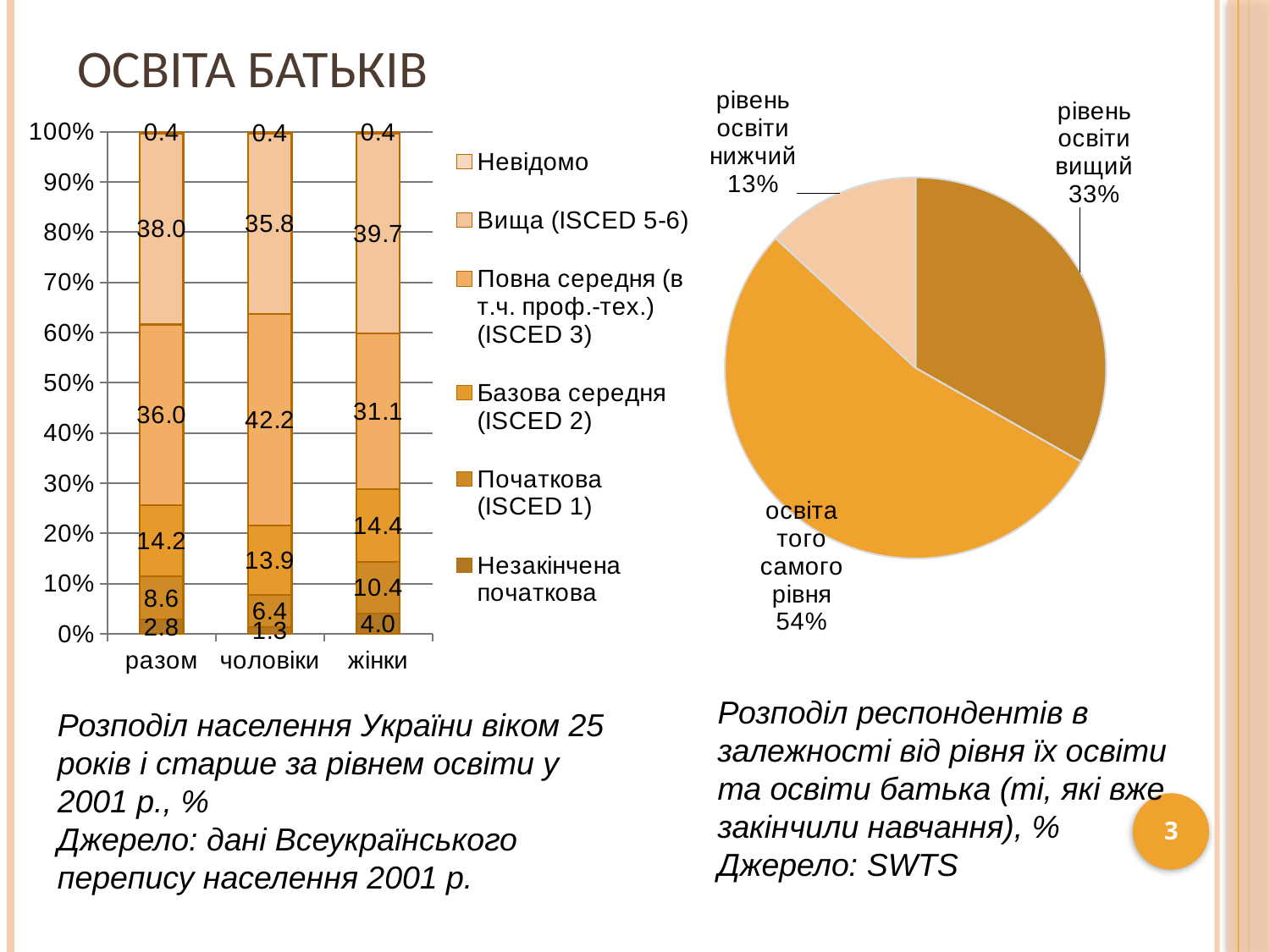
How many series does the legend of the left chart list? 6 What type of chart is the chart on the right of the slide? pie chart In the left stacked bar chart, which category has the lowest value for Повна середня (ISCED 3)? жінки In the left stacked bar chart, which category has the highest value for Незакінчена початкова? жінки In the right pie chart, which slice is the smallest? рівень освіти нижчий In the left stacked bar chart, what is the value of Вища (ISCED 5-6) for жінки? 39.7 In the left stacked bar chart, what is the difference between the Початкова (ISCED 1) values for жінки and чоловіки? 4.0 In the left stacked bar chart, what is the value of Початкова (ISCED 1) for разом? 8.6 In the right pie chart, what share is labelled освіта того самого рівня? 54% In the left stacked bar chart, what is the value of Повна середня (ISCED 3) for чоловіки? 42.2 In the left stacked bar chart, which is larger: Вища (ISCED 5-6) for разом or for чоловіки? разом How many categories are shown on the x axis of the left stacked bar chart? 3